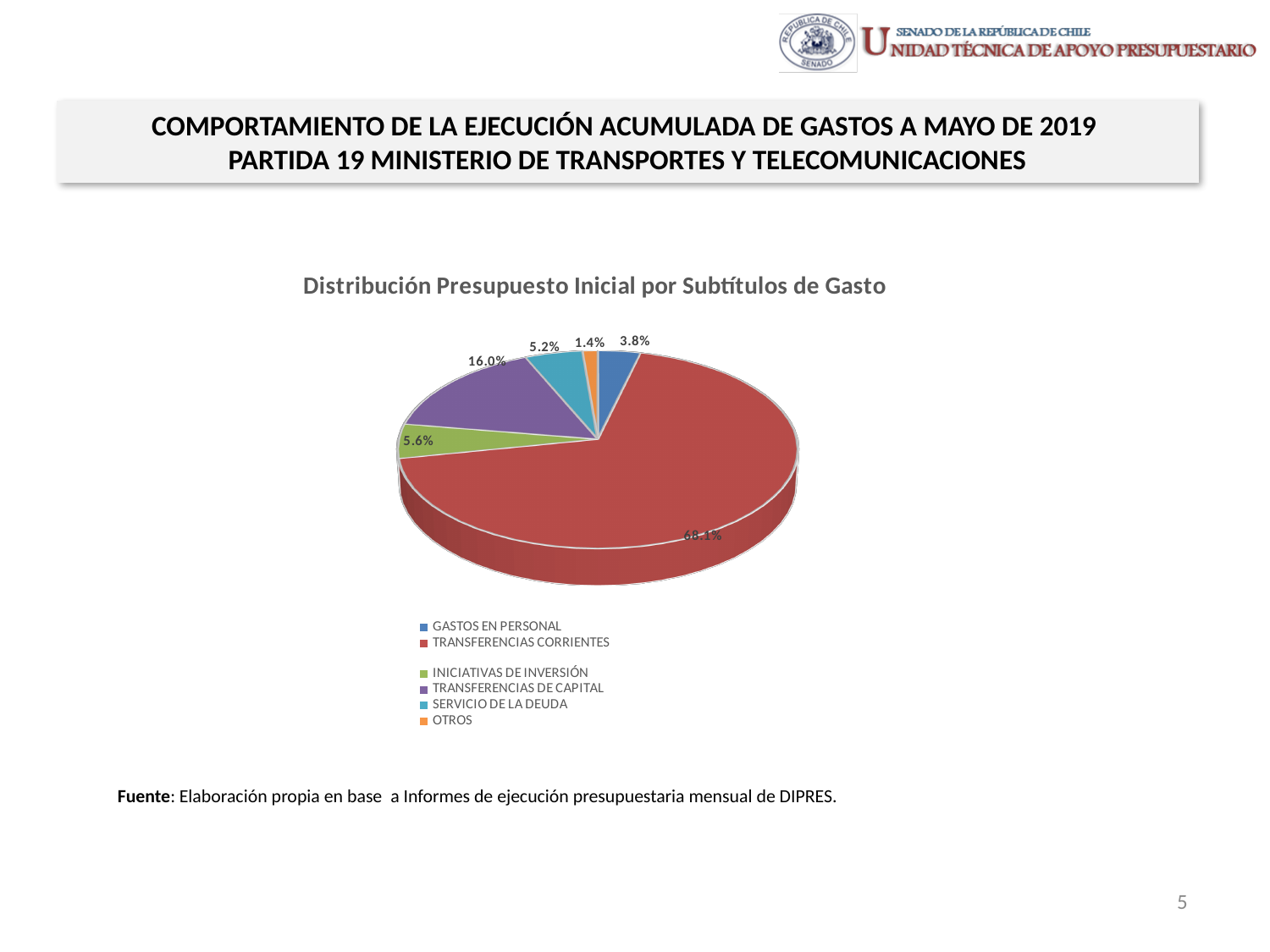
What is the value shown for SERVICIO DE LA DEUDA? 5.2% What is the value shown for INICIATIVAS DE INVERSIÓN? 5.6% Which category has the largest share of the pie? TRANSFERENCIAS CORRIENTES What is the difference in percentage points between TRANSFERENCIAS DE CAPITAL and GASTOS EN PERSONAL? 12.2 percentage points What share of the pie does TRANSFERENCIAS DE CAPITAL represent? 16.0% Which is larger, the share for INICIATIVAS DE INVERSIÓN or the share for OTROS? INICIATIVAS DE INVERSIÓN How many categories does the legend of the pie chart list? 6 What is the value shown for GASTOS EN PERSONAL? 3.8% What is the title of the chart? Distribución Presupuesto Inicial por Subtítulos de Gasto What share of the pie does TRANSFERENCIAS CORRIENTES represent? 68.1% What kind of chart is shown on the slide? Pie chart Which category has the smallest share of the pie? OTROS